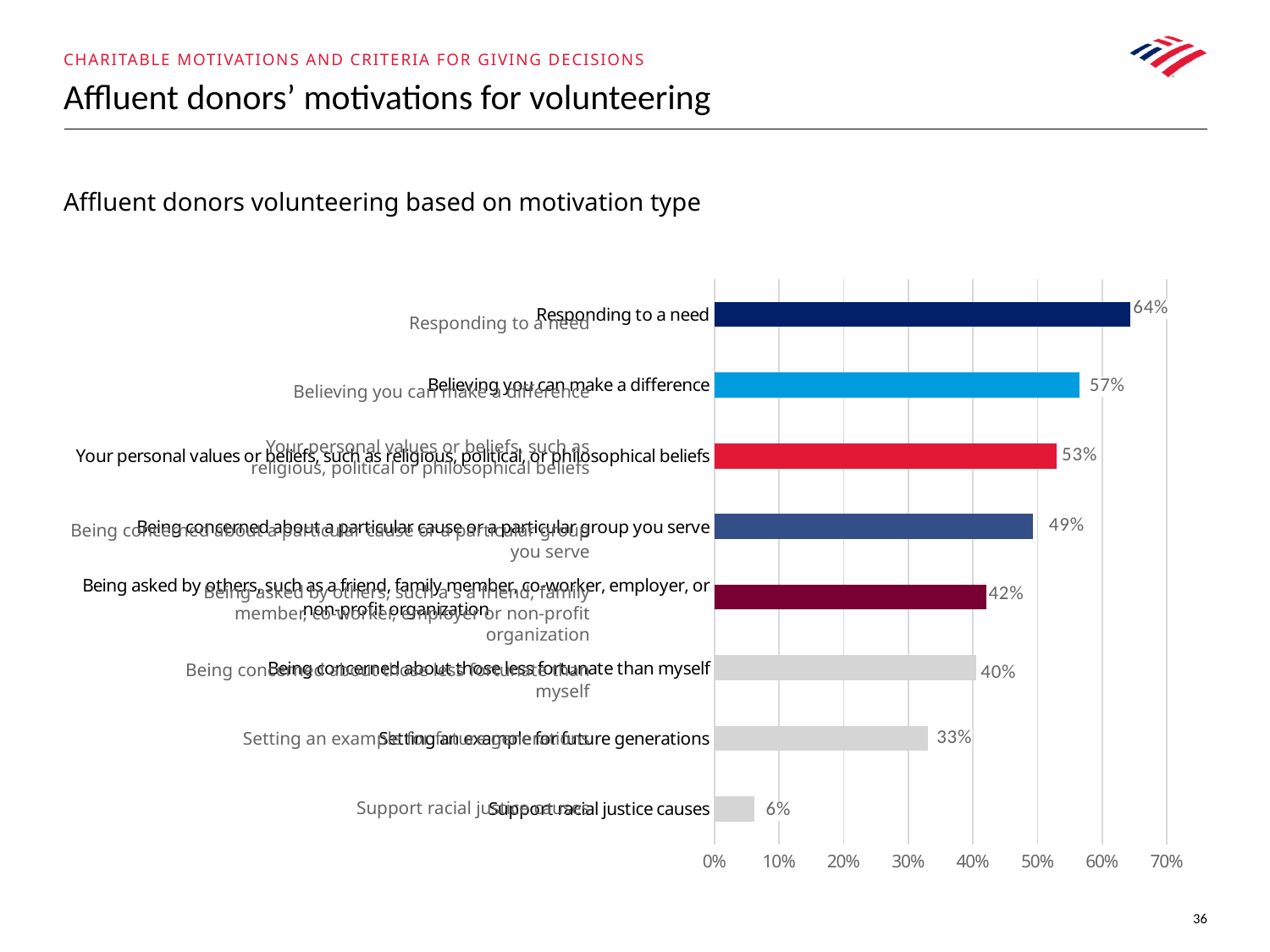
Which is larger: 'Being concerned about a particular cause or a particular group you serve' or 'Being concerned about those less fortunate than myself'? Being concerned about a particular cause or a particular group you serve What is the value for 'Support racial justice causes'? 6% Which motivation has the lowest percentage? Support racial justice causes What type of chart is used on this slide? Bar chart What is the difference between 'Responding to a need' and 'Believing you can make a difference'? 7 percentage points Which motivation has the highest percentage? Responding to a need What percentage is shown for 'Setting an example for future generations'? 33% How many motivation categories are shown in the chart? 8 What is the title of the chart? Affluent donors volunteering based on motivation type What percentage of affluent donors volunteer in response to a need? 64% What is the value for 'Believing you can make a difference'? 57% Is the value for 'Your personal values or beliefs, such as religious, political, or philosophical beliefs' greater or less than 50%? greater